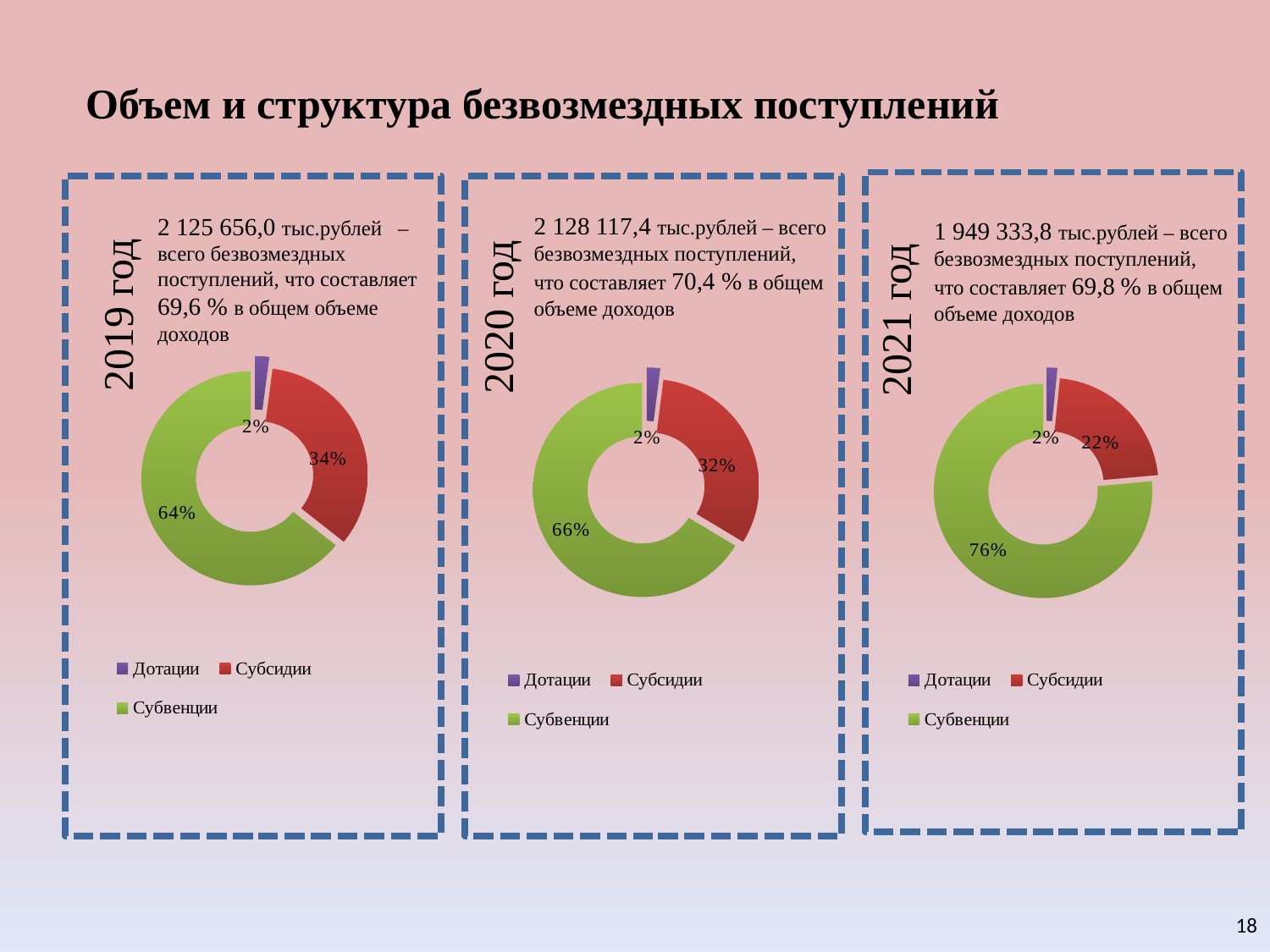
In the 2020 chart, which category has the smallest share? Дотации In the 2021 chart, what share does Субсидии have? 22% What kind of chart is used for the 2019 year? Doughnut (pie) chart Which colour represents Субсидии in the 2021 chart's legend? Red In the 2020 chart, what share does Субвенции have? 66% In the 2021 chart, what share does Дотации have? 2% In the 2021 chart, what is the difference between the shares of Субвенции and Субсидии? 54% In the 2019 chart, what share does Субсидии have? 34% In the 2021 chart, which category has the largest share? Субвенции How many series does the legend of the 2020 chart list? 3 In the 2019 chart, what share does Субвенции have? 64% In the 2019 chart, which is larger, the share of Субсидии or the share of Субвенции? Субвенции